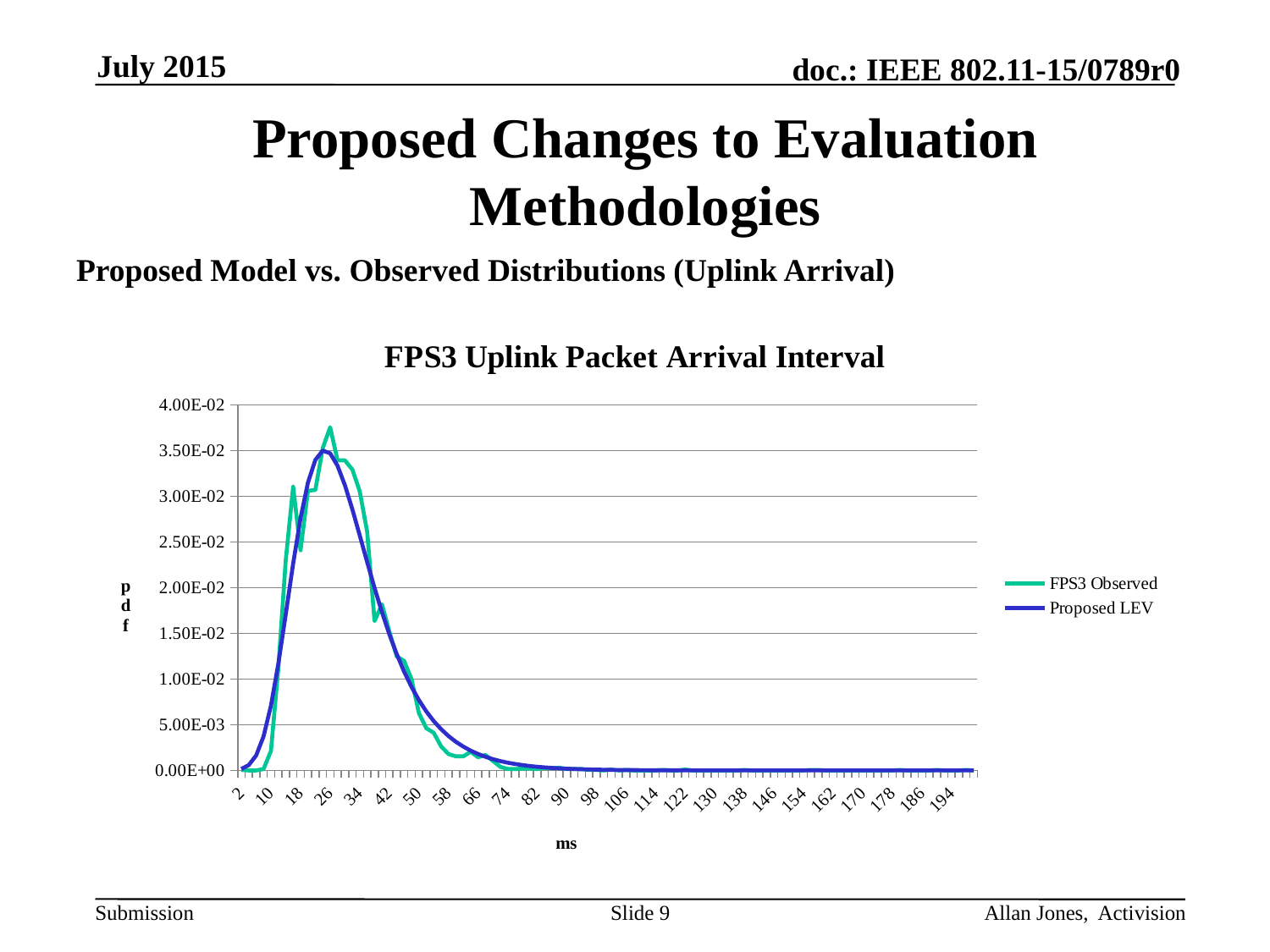
Is the value of the FPS3 Observed series at 18 ms greater or less than 2.00E-02? greater Is the peak value of the FPS3 Observed series greater or less than 3.50E-02? greater Is the value of the Proposed LEV series at 66 ms greater or less than 5.00E-03? less What type of chart is shown on the slide? line chart Which series reaches the higher peak value, FPS3 Observed or Proposed LEV? FPS3 Observed After the peak near 26 ms, do the values of the Proposed LEV series rise or fall as ms increases? fall What label is shown on the x axis of the chart? ms How many series does the legend list? 2 Between 2 ms and 26 ms, do the values of the Proposed LEV series rise or fall? rise What is the title of the chart? FPS3 Uplink Packet Arrival Interval